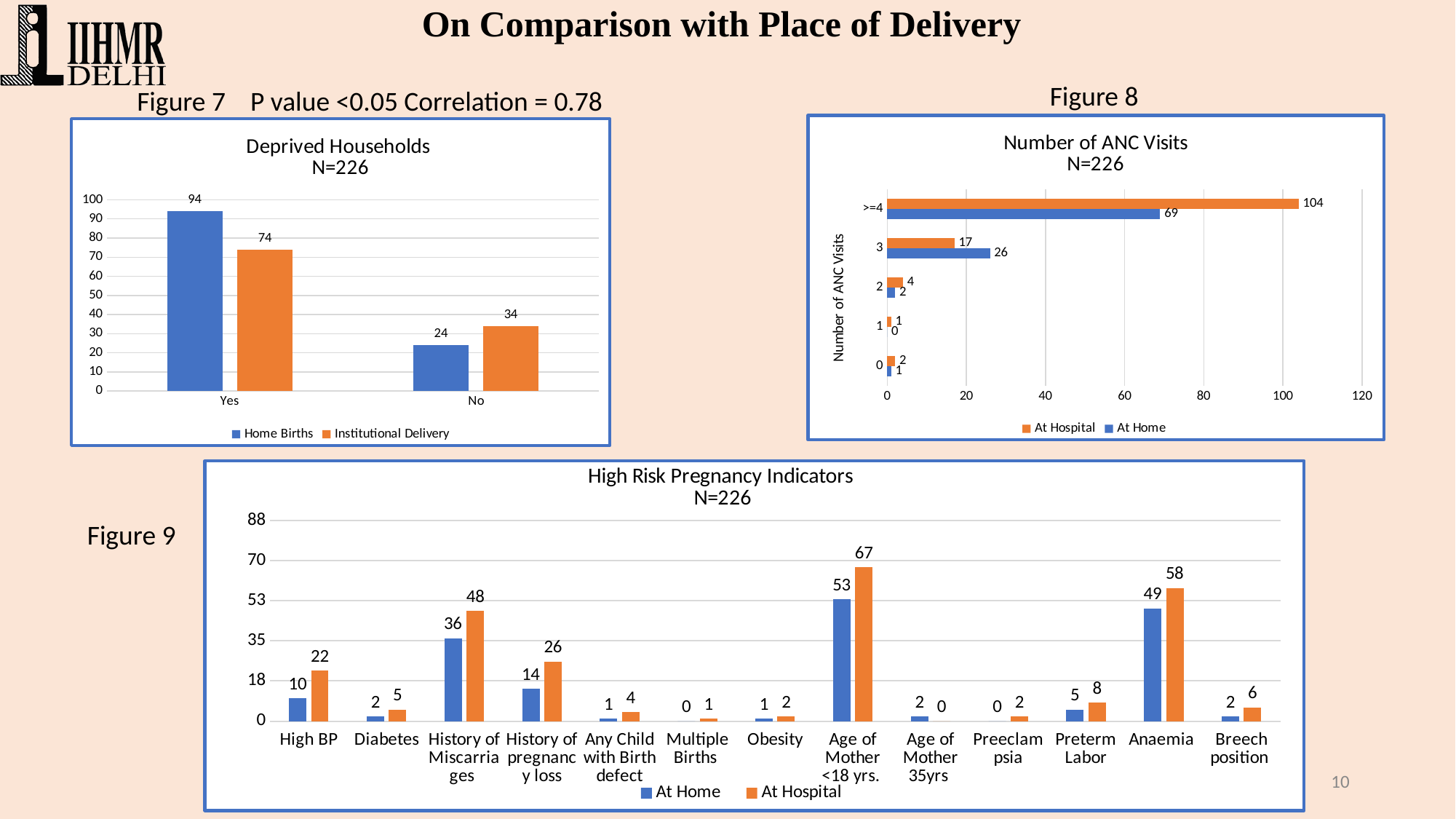
In the 'Deprived Households' chart, how many series does the legend list? 2 In the 'Number of ANC Visits' chart, what is the At Hospital value for >=4 visits? 104 In the 'Number of ANC Visits' chart, which category has the highest At Home value? >=4 In the 'High Risk Pregnancy Indicators' chart, which indicator has the highest At Hospital value? Age of Mother <18 yrs. In the 'High Risk Pregnancy Indicators' chart, how many indicator categories are shown on the x axis? 13 What kind of chart is the 'Number of ANC Visits' chart? Bar chart In the 'High Risk Pregnancy Indicators' chart, what is the difference between At Hospital and At Home for High BP? 12 In the 'High Risk Pregnancy Indicators' chart, which is larger for History of Miscarriages: At Home or At Hospital? At Hospital In the 'Deprived Households' chart, what is the value for Home Births in the Yes category? 94 In the 'Number of ANC Visits' chart, what is the difference between At Home and At Hospital for 3 visits? 9 In the 'Deprived Households' chart, what is the difference between Institutional Delivery and Home Births for the No category? 10 In the 'High Risk Pregnancy Indicators' chart, what is the At Hospital value for Anaemia? 58